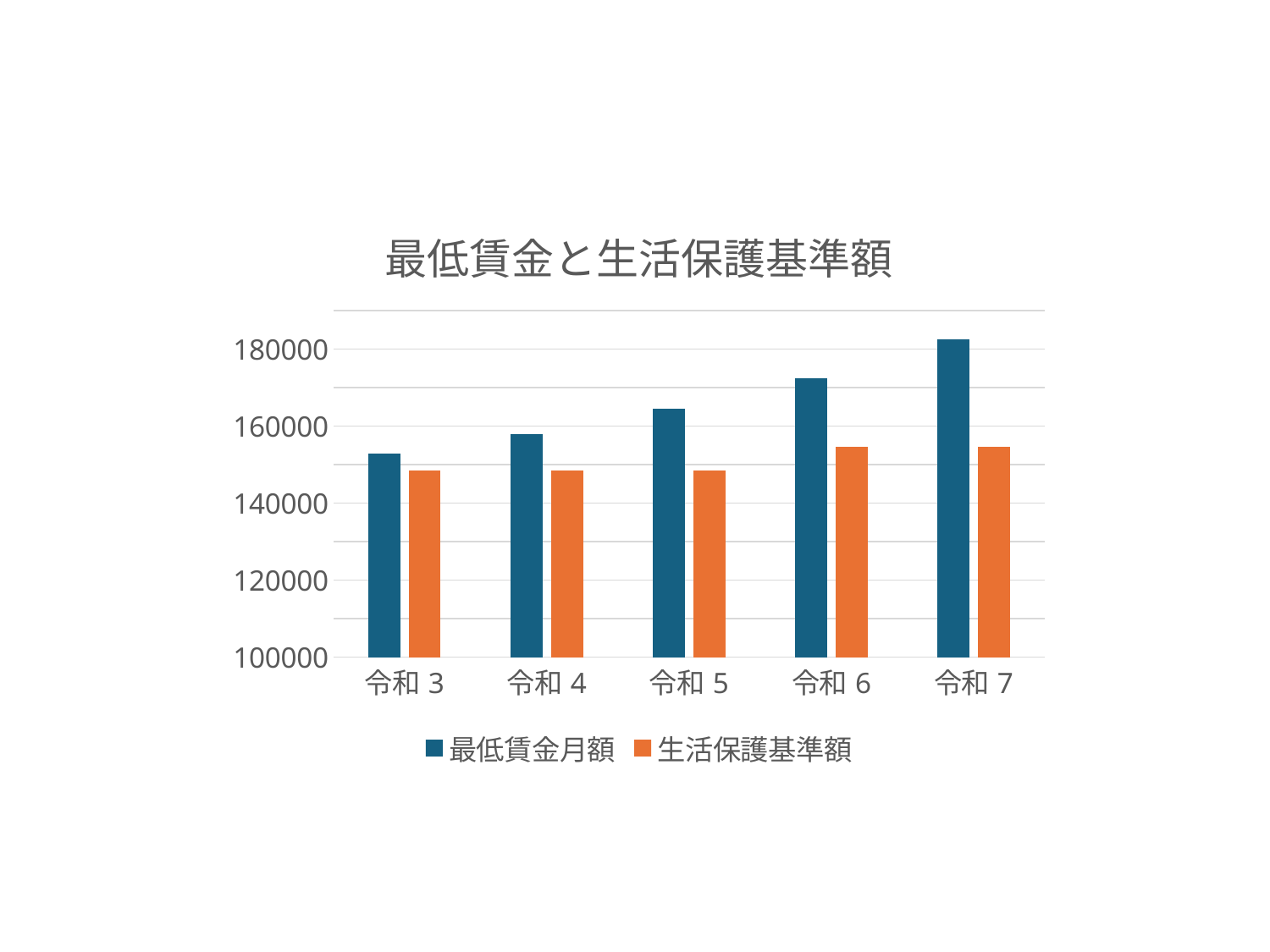
How many series does the legend list? 2 Is the value for 最低賃金月額 in 令和 7 greater or less than 180000? greater Which category has the lowest value for 最低賃金月額? 令和 3 Which category has the highest value for 最低賃金月額? 令和 7 Is the value for 最低賃金月額 in 令和 3 greater or less than 160000? less In 令和 7, which is larger: 最低賃金月額 or 生活保護基準額? 最低賃金月額 Do the values for 最低賃金月額 rise or fall from 令和 3 to 令和 7? rise How many categories are shown on the x axis? 5 What is the title of the chart? 最低賃金と生活保護基準額 Is the value for 生活保護基準額 in 令和 3 greater or less than 140000? greater What kind of chart is shown on the slide? bar chart